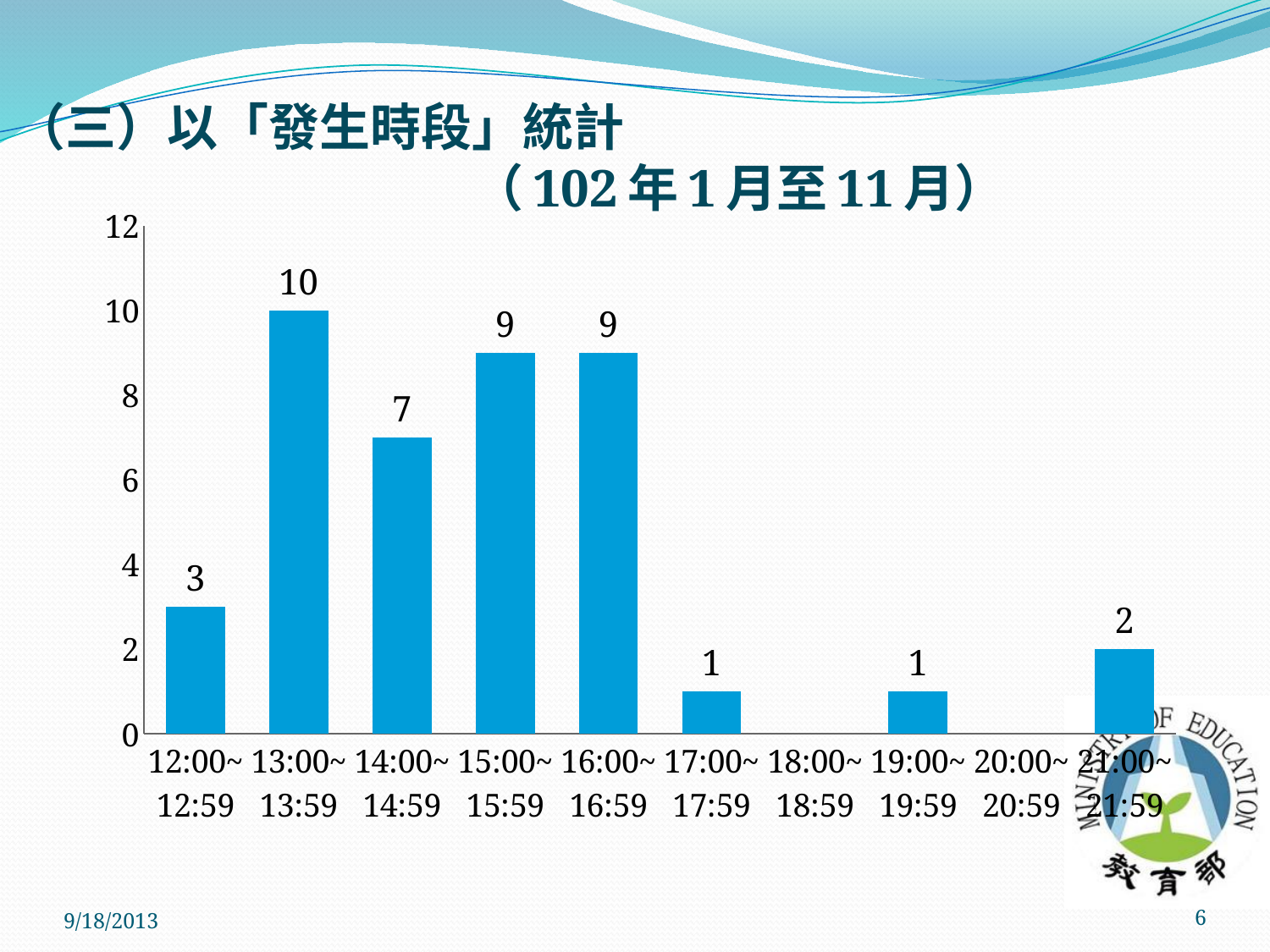
Is the value for 16:00~16:59 greater or less than 8? greater Which time slot has the highest value? 13:00~13:59 What is the difference between the values for 13:00~13:59 and 14:00~14:59? 3 What is the value for the 21:00~21:59 time slot? 2 What is the value for the 12:00~12:59 time slot? 3 What is the highest value shown on the vertical axis? 12 What is the value for the 13:00~13:59 time slot? 10 What is the value for the 14:00~14:59 time slot? 7 What kind of chart is shown on the slide? bar chart What is the difference between the values for 15:00~15:59 and 17:00~17:59? 8 Which is larger, the value for 12:00~12:59 or the value for 21:00~21:59? 12:00~12:59 How many time slots are shown on the x axis? 10